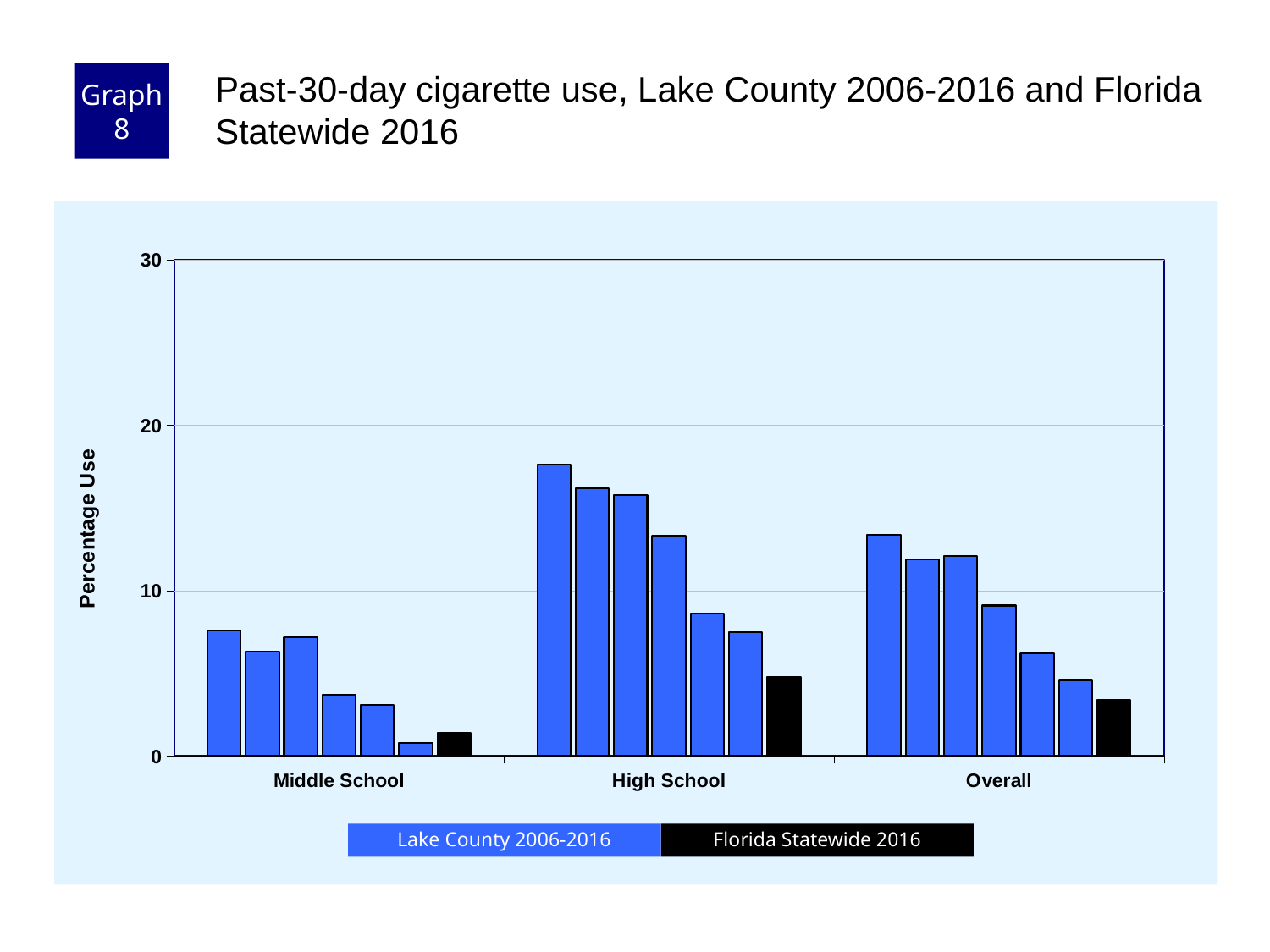
Which category has the tallest bar in the chart? High School What is the title of the y axis? Percentage Use Within the High School group, do the Lake County 2006-2016 bars generally rise or fall from left to right? fall Is the Florida Statewide 2016 value for Middle School greater or less than 10? less How many categories are shown on the x axis? 3 Is the Florida Statewide 2016 value for High School greater or less than 10? less Which category has the lowest Florida Statewide 2016 bar? Middle School Which is larger: the Florida Statewide 2016 value for High School or for Middle School? High School Is the tallest Lake County 2006-2016 bar for High School greater or less than 20? less How many series does the legend list? 2 What kind of chart is shown on the slide? bar chart